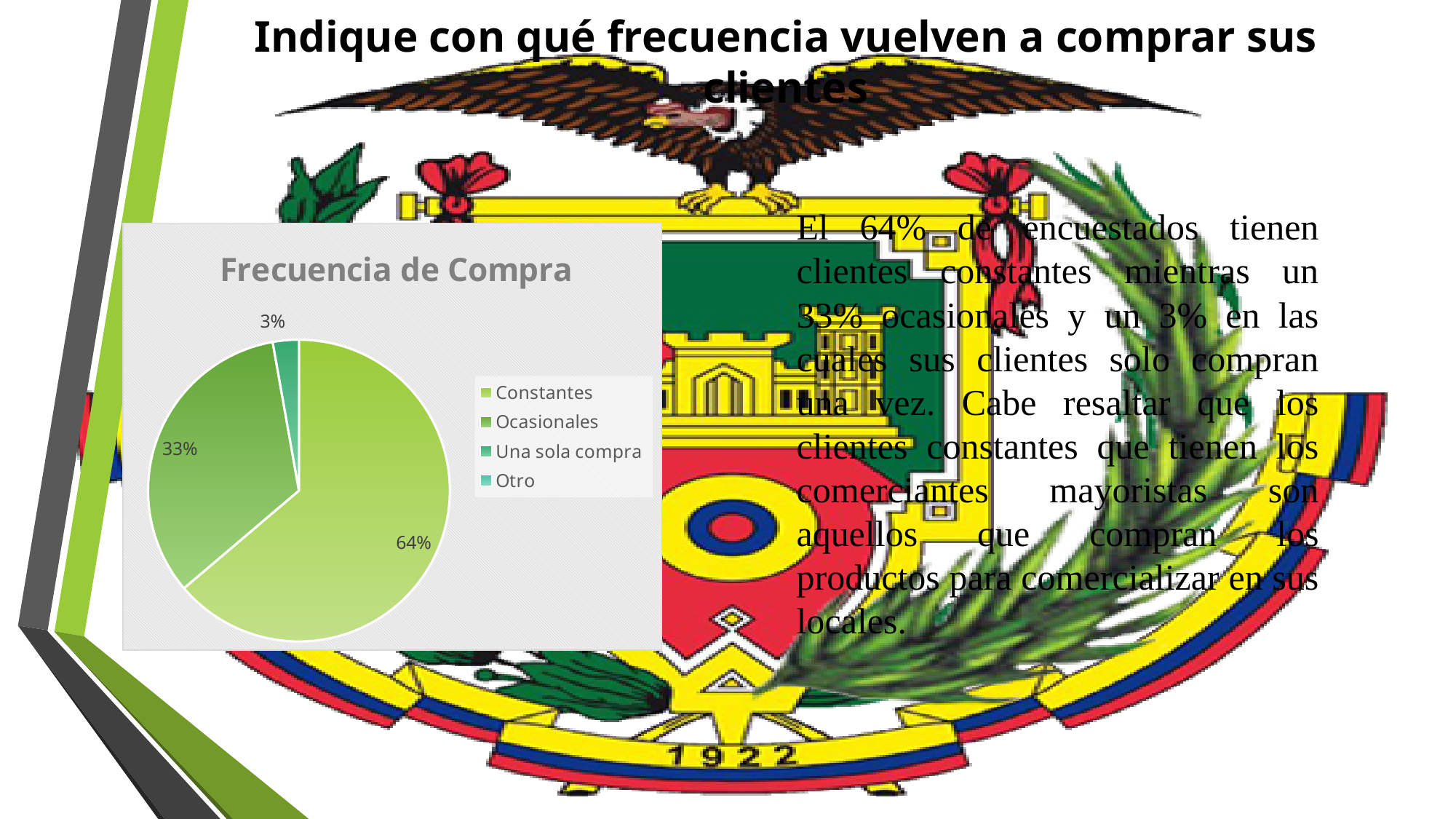
What kind of chart is shown on the slide? pie chart What percentage of the pie is labelled for Ocasionales? 33% What percentage of the pie is labelled for Constantes? 64% What is the combined share of the Constantes and Ocasionales slices? 97% What percentage of the pie is labelled for Una sola compra? 3% What is the difference in percentage points between the Ocasionales and Una sola compra slices? 30% How many entries does the chart legend list? 4 Among the slices with a printed percentage, which is the smallest? Una sola compra Which category has the largest slice of the pie? Constantes What is the title of the chart? Frecuencia de Compra What is the difference in percentage points between the Constantes and Ocasionales slices? 31% Which slice is larger, Constantes or Ocasionales? Constantes